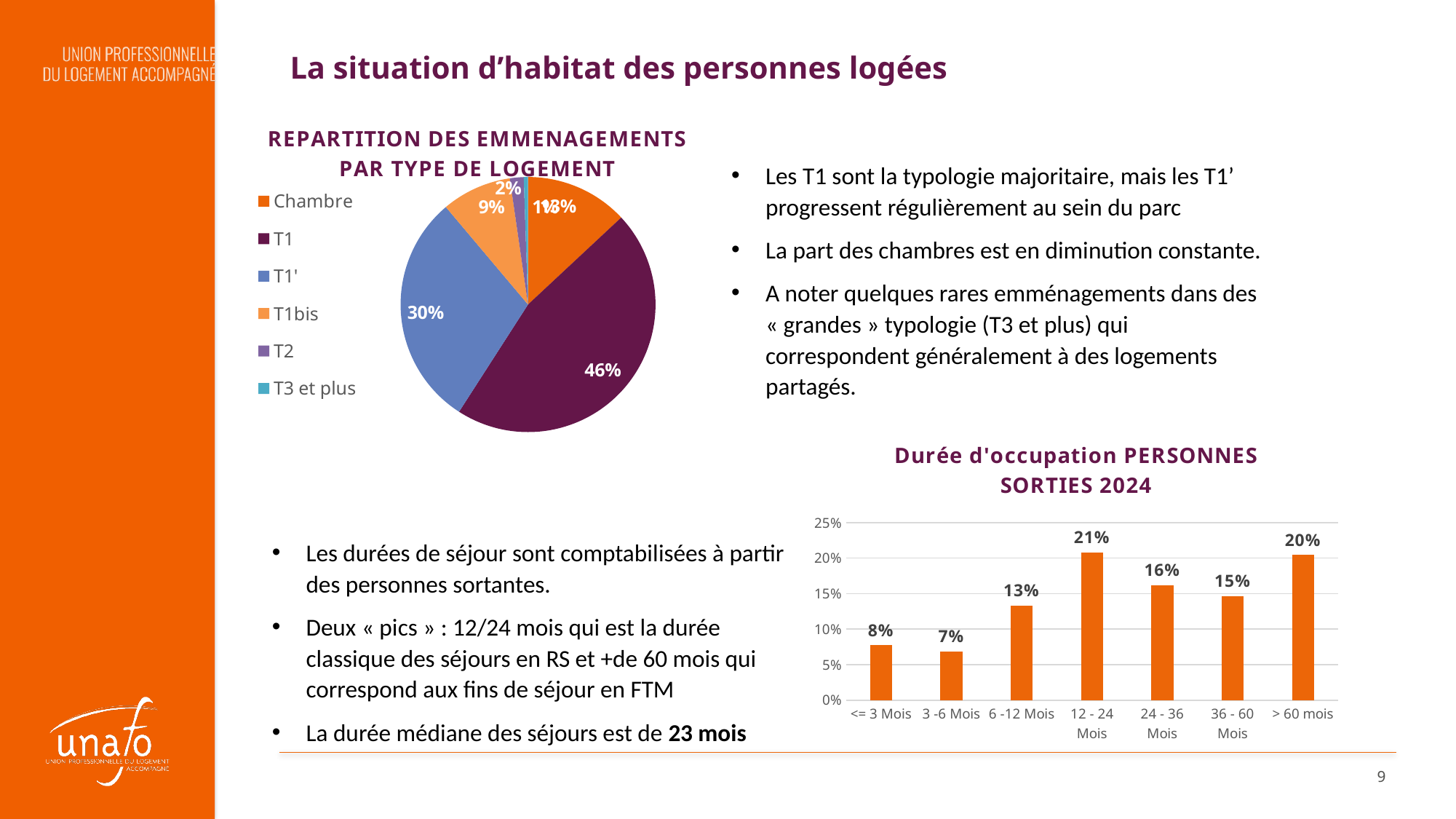
In the chart 'Durée d'occupation PERSONNES SORTIES 2024', what is the value for '12 - 24 Mois'? 21% How many categories are shown in the chart 'Durée d'occupation PERSONNES SORTIES 2024'? 7 What kind of chart is 'Durée d'occupation PERSONNES SORTIES 2024'? Bar chart In the chart 'Durée d'occupation PERSONNES SORTIES 2024', what is the value for '3 -6 Mois'? 7% How many entries does the legend of the pie chart 'REPARTITION DES EMMENAGEMENTS PAR TYPE DE LOGEMENT' list? 6 In the chart 'Durée d'occupation PERSONNES SORTIES 2024', which category has the highest value? 12 - 24 Mois In the chart 'Durée d'occupation PERSONNES SORTIES 2024', which category has the lowest value? 3 -6 Mois In the chart 'Durée d'occupation PERSONNES SORTIES 2024', what is the value for '> 60 mois'? 20% In the chart 'Durée d'occupation PERSONNES SORTIES 2024', what is the difference between the values for '24 - 36 Mois' and '6 -12 Mois'? 3% In the chart 'Durée d'occupation PERSONNES SORTIES 2024', which is larger: the value for '<= 3 Mois' or the value for '36 - 60 Mois'? 36 - 60 Mois In the pie chart 'REPARTITION DES EMMENAGEMENTS PAR TYPE DE LOGEMENT', what share does T1 have? 46% In the pie chart 'REPARTITION DES EMMENAGEMENTS PAR TYPE DE LOGEMENT', what share does T1' have? 30%